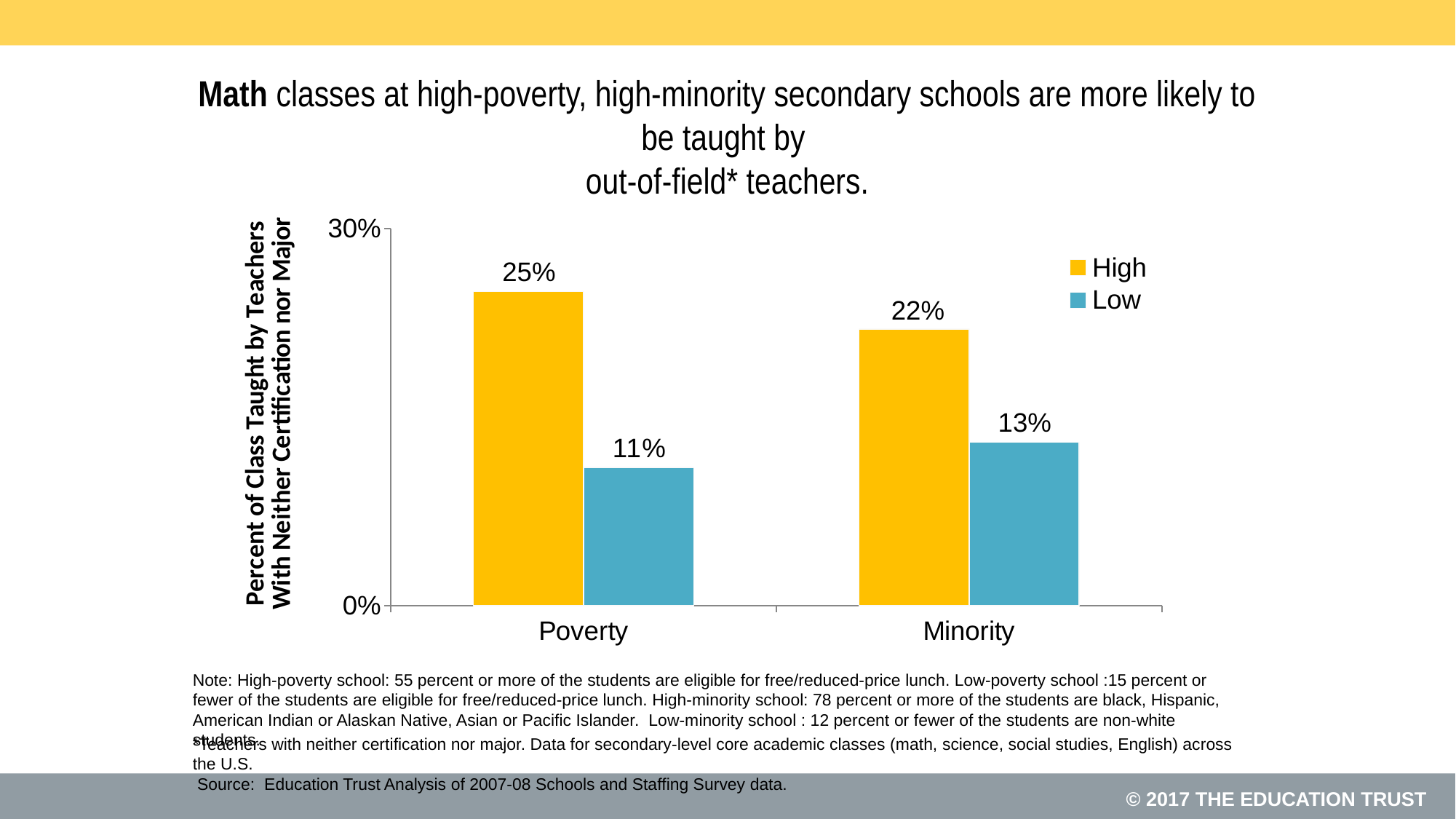
What is the value for Low in the Minority category? 13% What is the difference between the High and Low values in the Poverty category? 14% What is the difference between the High values for Poverty and Minority? 3% How many series does the legend list? 2 Which bar has the lowest value on the chart? Low, Poverty What is the value for High in the Poverty category? 25% What is the label of the vertical axis? Percent of Class Taught by Teachers With Neither Certification nor Major Which is larger, the Low value for Poverty or the Low value for Minority? Low value for Minority Which bar has the highest value on the chart? High, Poverty What is the value for Low in the Poverty category? 11% How many categories are shown on the x axis? 2 What kind of chart is shown on the slide? Bar chart